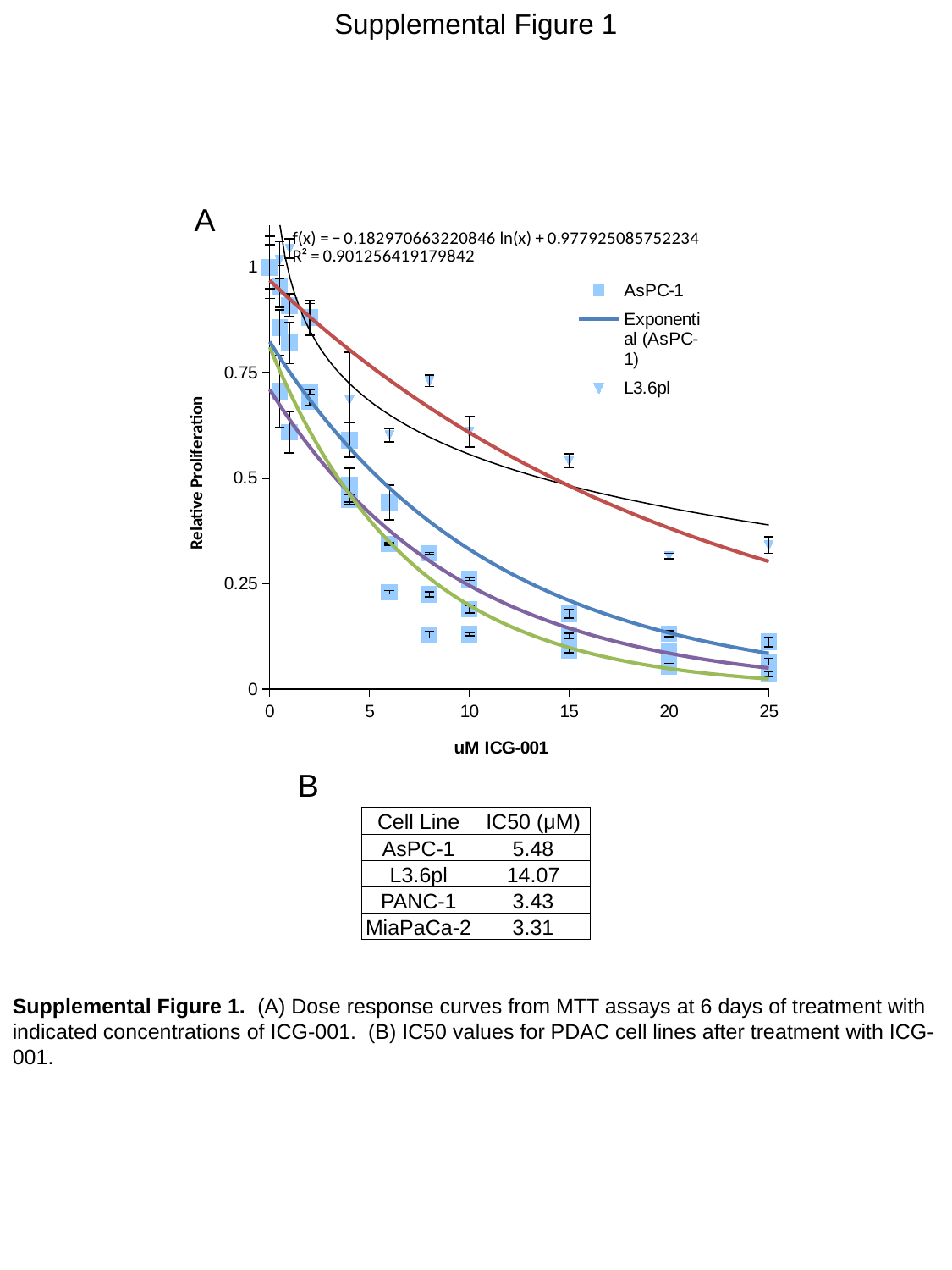
What is the title of the y axis of the panel A chart? Relative Proliferation In the panel A chart, how many entries does the legend list? 3 In the panel A chart, at 20 uM ICG-001, which series has the higher relative proliferation, AsPC-1 or L3.6pl? L3.6pl In the panel A chart, is the L3.6pl value at 8 uM ICG-001 greater or less than 0.5? greater In the panel A chart, what R² value is printed for the fitted trendline? 0.901256419179842 In the panel A chart, do the relative proliferation values rise or fall as the ICG-001 concentration increases? fall In the panel A chart, what is the highest value shown on the x axis? 25 In the panel A chart, is the L3.6pl value at 20 uM ICG-001 greater or less than 0.5? less What kind of chart is shown in panel A? scatter chart In the panel A chart, is the AsPC-1 value at 25 uM ICG-001 greater or less than 0.25? less What is the title of the x axis of the panel A chart? uM ICG-001